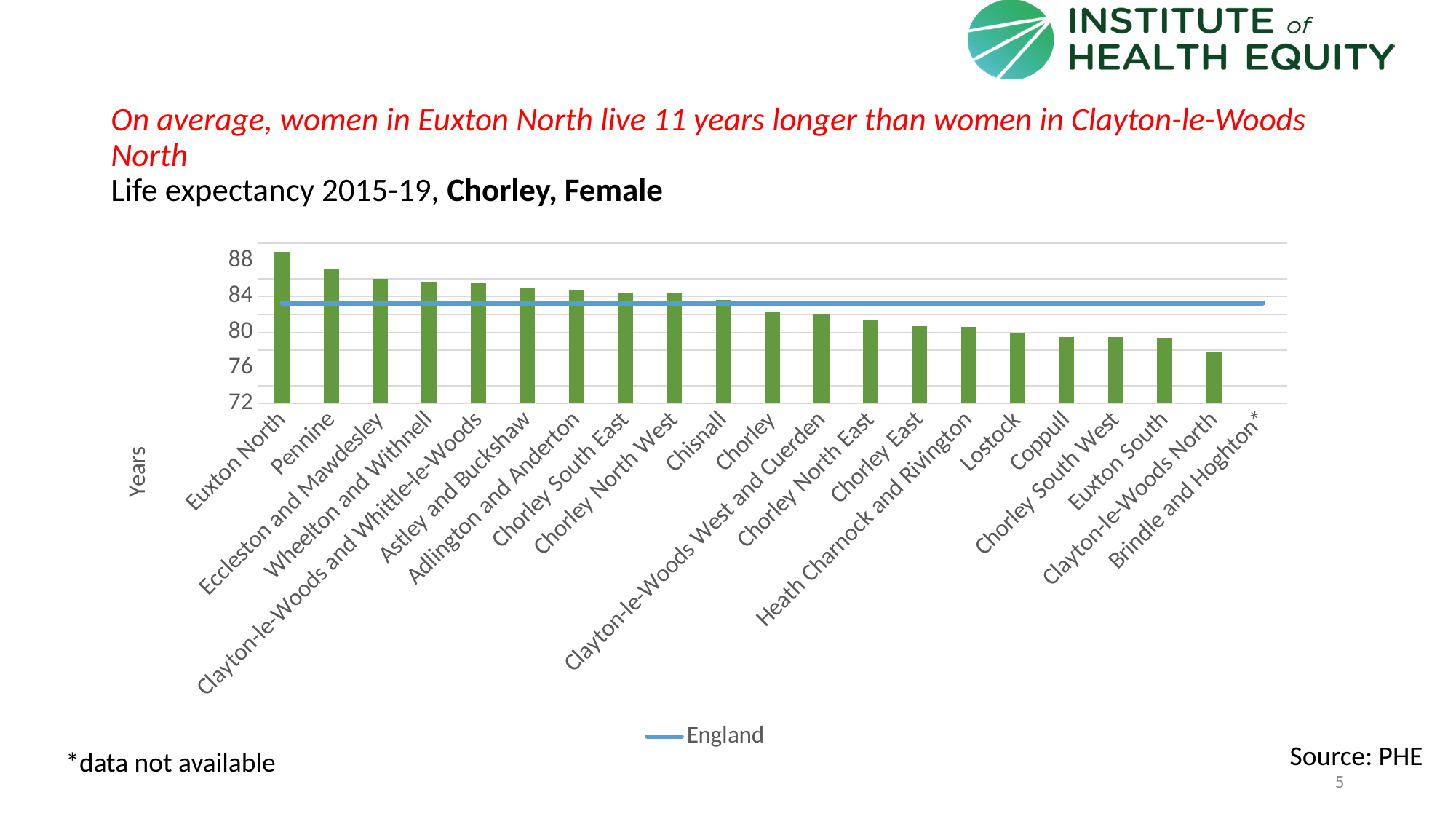
Is the value for Pennine greater or less than 84? greater Is the value for Coppull greater or less than 80? less Is the value for Chorley greater or less than 80? greater Which area with a plotted bar has the lowest female life expectancy? Clayton-le-Woods North Which area on the x axis has no bar because data is not available? Brindle and Hoghton Which area has the highest female life expectancy in the chart? Euxton North What kind of chart is shown on the slide? bar chart Which is larger, the value for Pennine or the value for Chorley East? Pennine What does the horizontal blue line in the chart represent, according to the legend? England How many areas have a bar plotted in the chart? 20 Do the bar values rise or fall moving from left to right along the x axis? fall